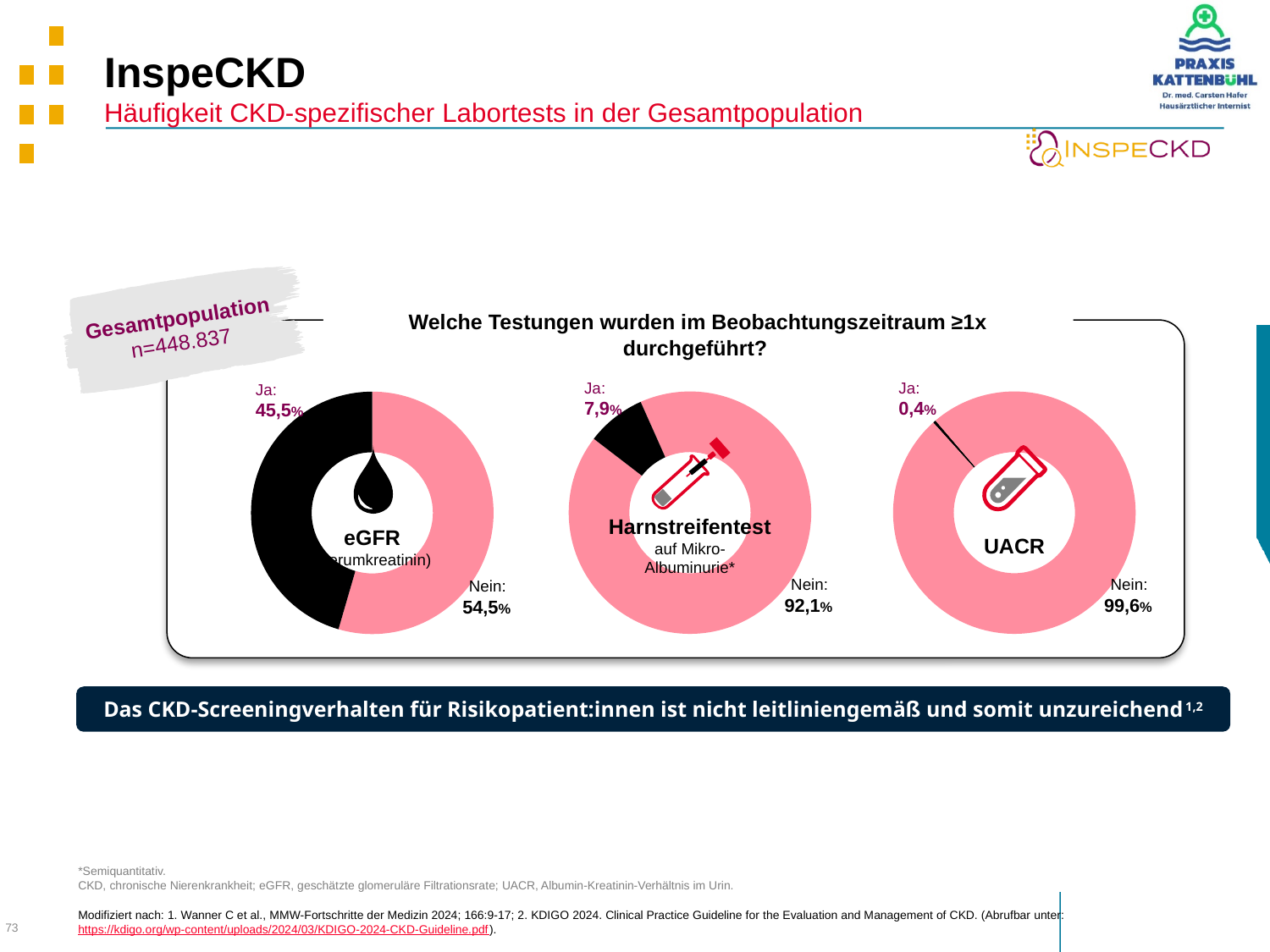
Across the three charts, which test has the lowest Ja share? UACR In the Harnstreifentest chart, what is the value for Nein? 92,1% In the eGFR chart, which is larger, Ja or Nein? Nein Across the three charts, which test has the highest Ja share? eGFR In the Harnstreifentest chart, what is the value for Ja? 7,9% In the eGFR chart, what is the value for Nein? 54,5% In the UACR chart, what is the value for Nein? 99,6% How many donut charts are shown on the slide? 3 What is the difference between the Ja share for eGFR and the Ja share for Harnstreifentest? 37,6% In the UACR chart, what is the value for Ja? 0,4% In the eGFR chart, what share of the population had the test performed at least once (Ja)? 45,5% What kind of chart is used for eGFR, Harnstreifentest and UACR? Donut (pie) chart